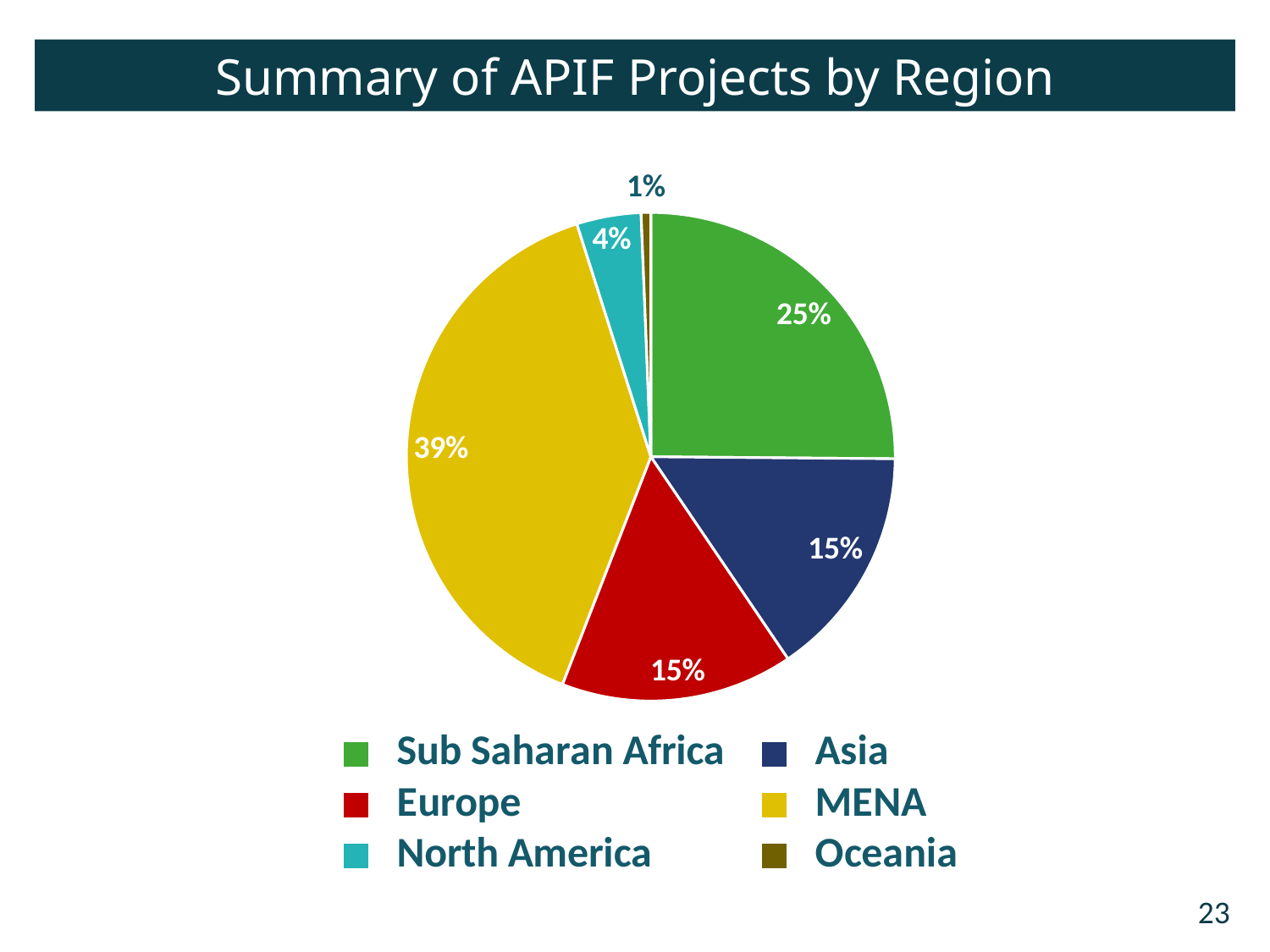
What share of APIF projects is in Oceania? 1% What share of APIF projects is in MENA? 39% Which region has the smallest share of APIF projects? Oceania What is the title of the chart? Summary of APIF Projects by Region How many regions are shown in the pie chart? 6 What share of APIF projects is in North America? 4% Which has a larger share of APIF projects, Sub Saharan Africa or Europe? Sub Saharan Africa What kind of chart is shown on the slide? Pie chart What is the difference in percentage points between the MENA share and the Sub Saharan Africa share? 14 Which region has the largest share of APIF projects? MENA Which region is represented by the red slice? Europe